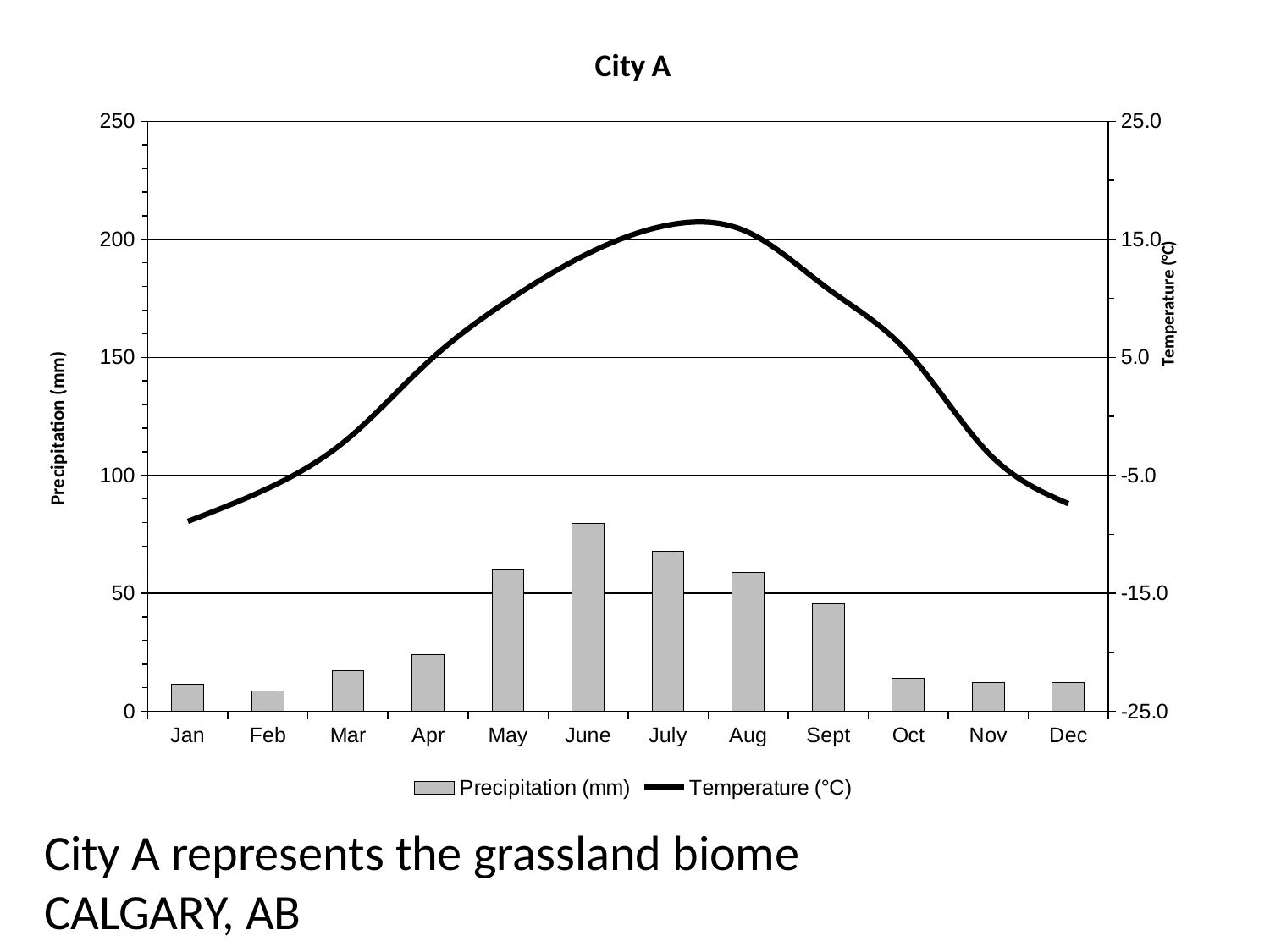
Which month has the lowest temperature? Jan What is the title of the chart? City A Which month has the highest precipitation? June Which month has the lowest precipitation? Feb How many months are shown on the x axis? 12 Does the temperature line rise or fall from Jan to July? rise Is the temperature for Jan greater or less than -5.0°C? less Which month has higher precipitation, June or July? June What kind of chart is this? Combination bar and line chart How many series does the legend list? 2 Is the precipitation for Apr greater or less than 50 mm? less Is the precipitation for June greater or less than 50 mm? greater